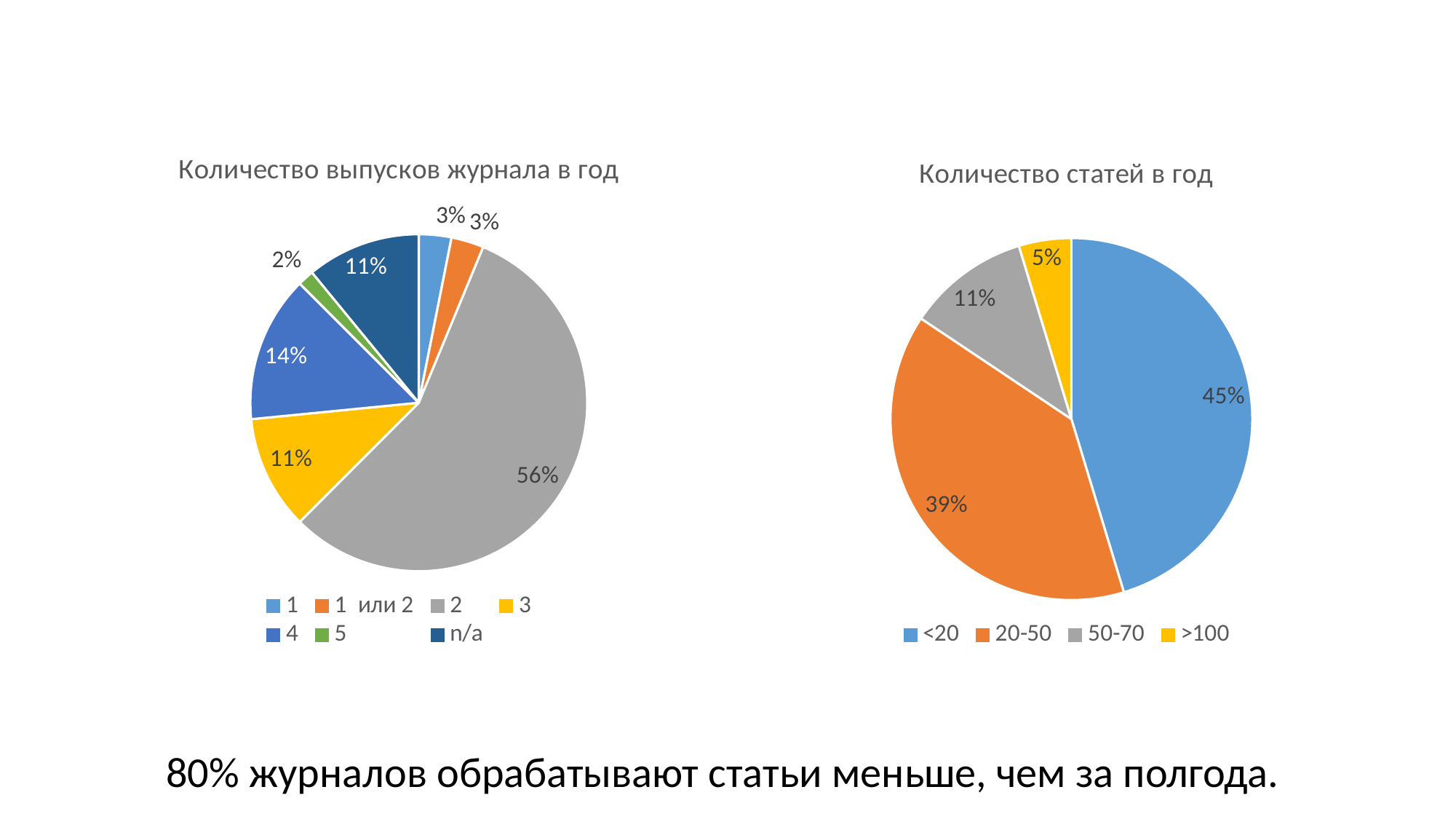
In the chart titled "Количество статей в год", what is the value for the category "20-50"? 39% In the chart titled "Количество статей в год", which category has the largest share? <20 In the chart titled "Количество статей в год", what is the difference between the shares of "<20" and "20-50"? 6% In the chart titled "Количество выпусков журнала в год", which category has the smallest share? 5 In the chart titled "Количество выпусков журнала в год", which category has the largest share? 2 In the chart titled "Количество статей в год", which is larger: the share of "50-70" or the share of ">100"? 50-70 In the chart titled "Количество выпусков журнала в год", what is the difference between the shares of "4" and "3"? 3% In the chart titled "Количество выпусков журнала в год", what share of the pie does the category "2" take? 56% In the chart titled "Количество статей в год", which category has the smallest share? >100 What type of chart is the chart on the right side of the slide? Pie chart In the chart titled "Количество выпусков журнала в год", what is the value for the category "4"? 14% In the chart titled "Количество выпусков журнала в год", how many categories does the legend list? 7